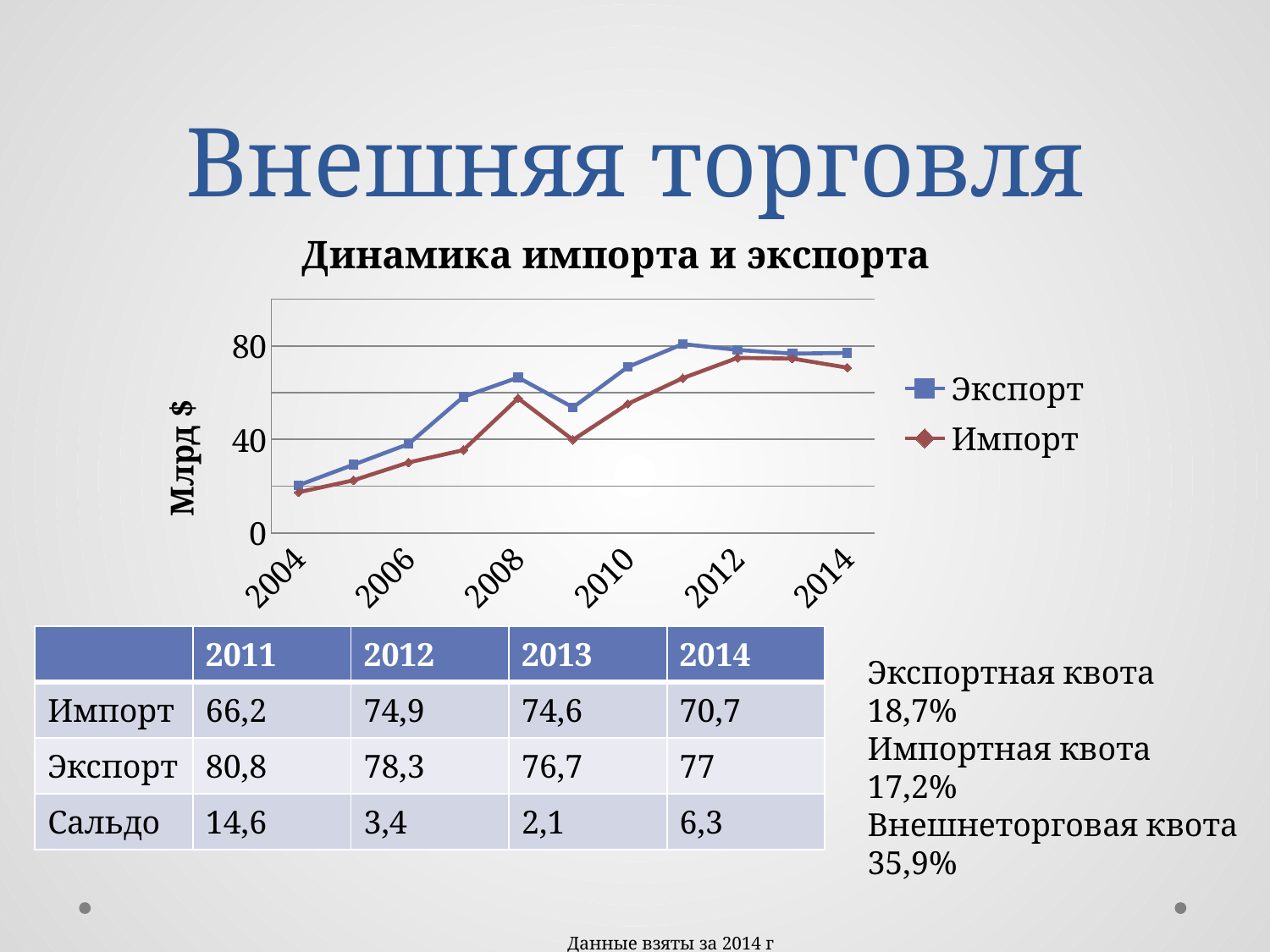
What kind of chart is shown under the title "Динамика импорта и экспорта"? line chart What are the two series named in the chart legend? Экспорт and Импорт What is the label of the vertical axis of the chart? Млрд $ In 2008, which series has the higher value, Экспорт or Импорт? Экспорт Does the Экспорт line rise or fall from 2008 to 2009? fall Is the value for Импорт in 2014 greater or less than 80? less How many series does the legend of the chart list? 2 In which year does the Экспорт line reach its highest value? 2011 Is the value for Экспорт in 2004 greater or less than 40? less Does the Импорт line rise or fall from 2004 to 2008? rise Is the value for Импорт in 2006 greater or less than 40? less